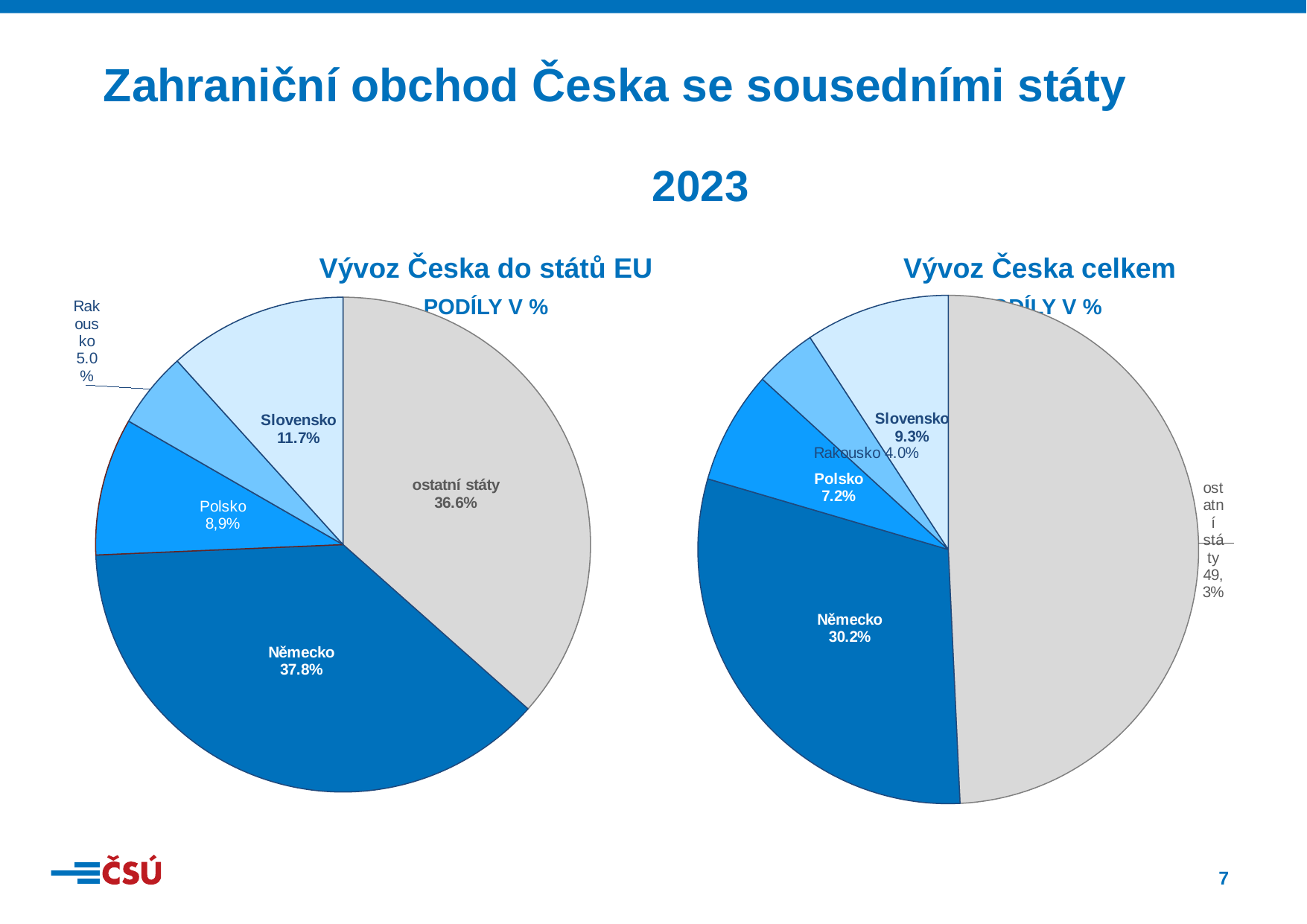
In the chart titled "Vývoz Česka do států EU", what share does Německo have? 37.8% In the chart titled "Vývoz Česka celkem", what share does Německo have? 30.2% In the chart titled "Vývoz Česka celkem", what is the difference between the share of Německo and the share of Slovensko? 20.9 percentage points In the chart titled "Vývoz Česka do států EU", which is larger, the share of Slovensko or the share of Polsko? Slovensko In the chart titled "Vývoz Česka do států EU", what share does Polsko have? 8,9% In the chart titled "Vývoz Česka do států EU", what share does Slovensko have? 11.7% In the chart titled "Vývoz Česka celkem", what share do ostatní státy have? 49,3% What type of chart is used on the left side of the slide? Pie chart In the chart titled "Vývoz Česka celkem", which slice is the largest? ostatní státy In the chart titled "Vývoz Česka celkem", which slice is the smallest? Rakousko In the chart titled "Vývoz Česka do států EU", what share does Rakousko have? 5.0% In the chart titled "Vývoz Česka celkem", what share does Rakousko have? 4.0%